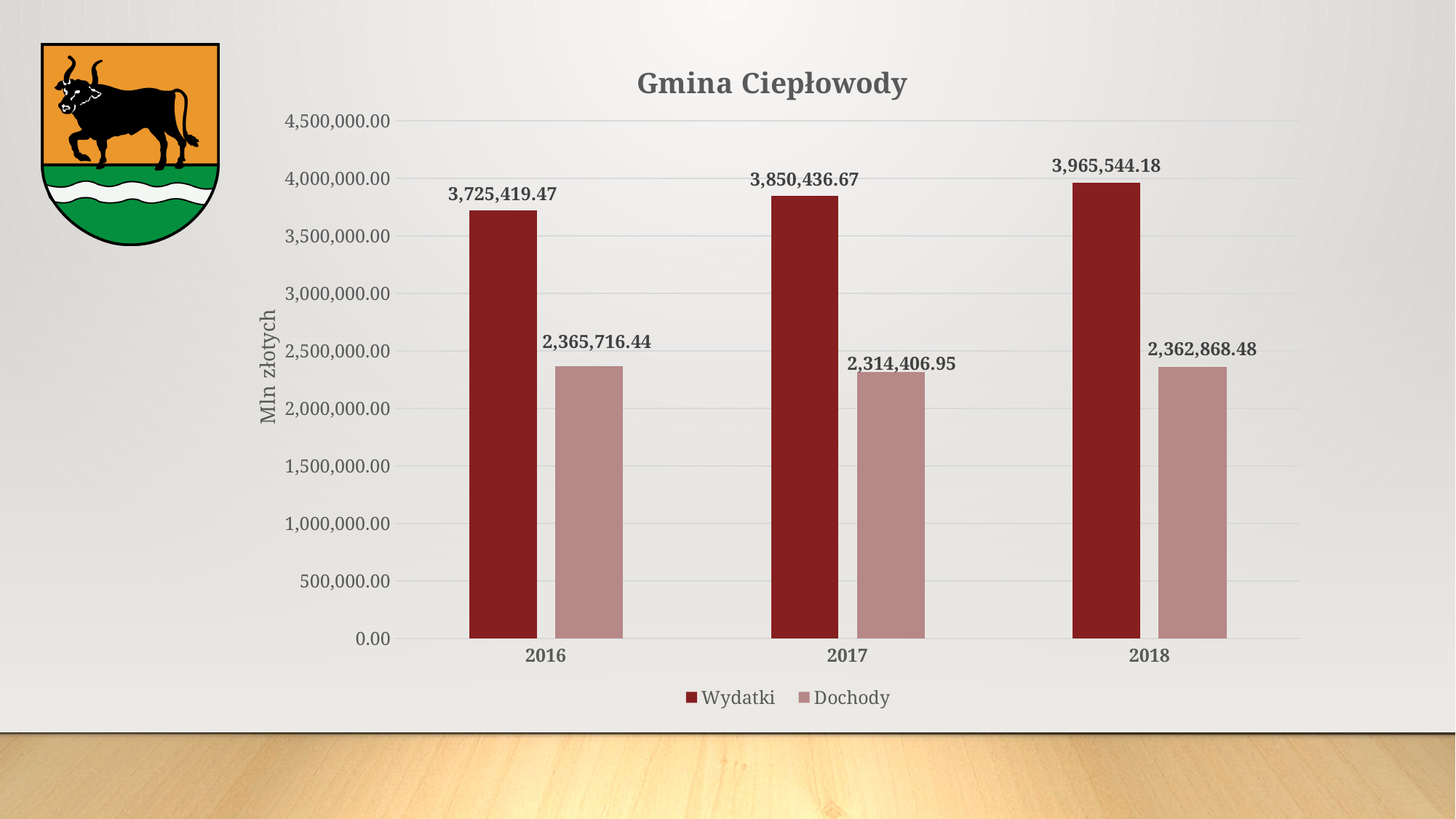
What is the value of Dochody for 2016? 2,365,716.44 Does Wydatki rise or fall from 2016 to 2018? rise Which is larger in 2016, Wydatki or Dochody? Wydatki What is the value of Dochody for 2018? 2,362,868.48 Is the value of Wydatki for 2016 greater or less than 3,500,000.00? greater In which year is Dochody the lowest? 2017 In which year is Wydatki the highest? 2018 How much higher is Wydatki in 2018 than in 2016? 240,124.71 What is the value of Wydatki for 2017? 3,850,436.67 How many years are shown on the x axis? 3 What is the difference between Wydatki and Dochody in 2018? 1,602,675.70 How many series does the legend list? 2